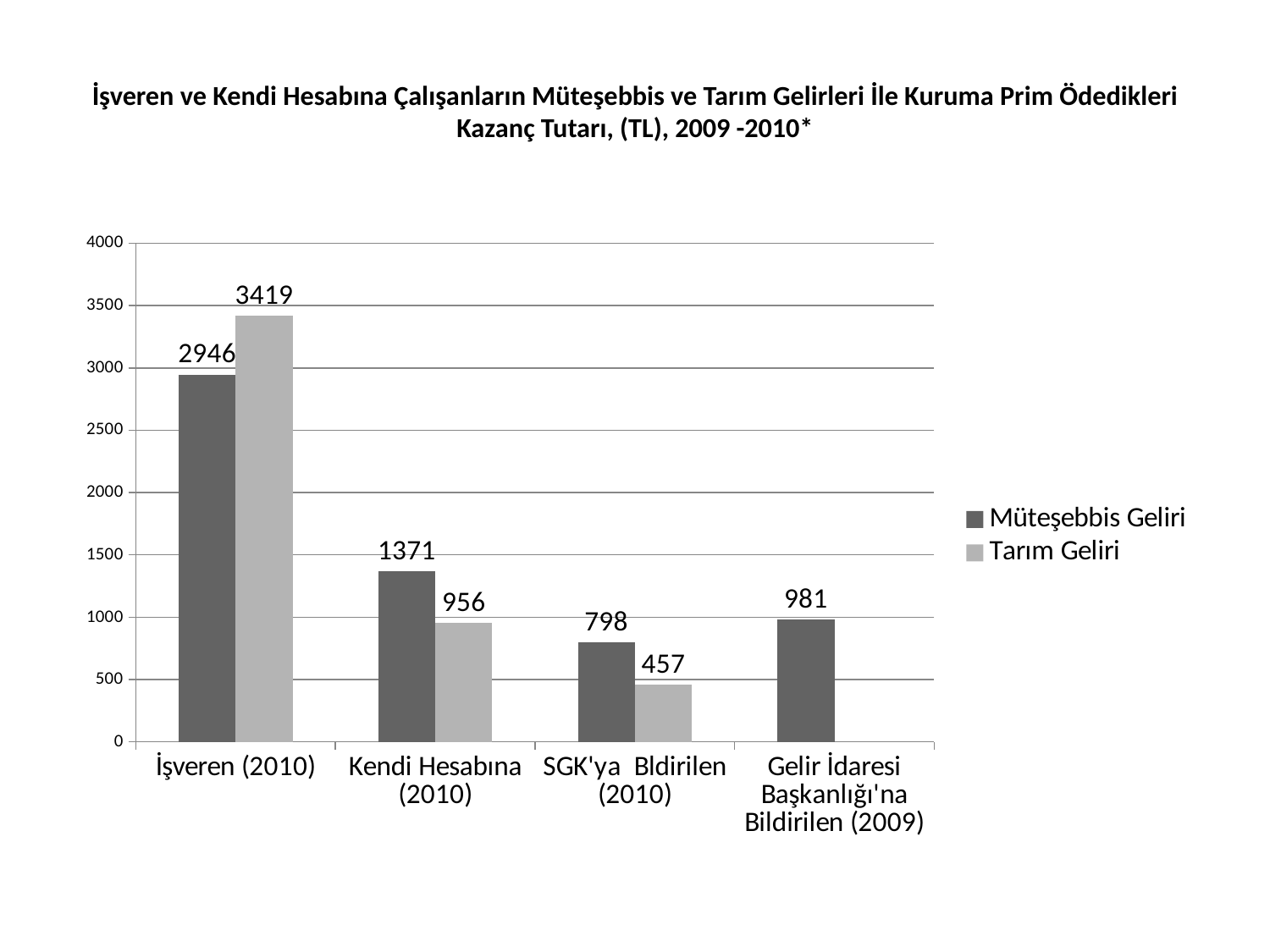
Which category has the highest Tarım Geliri value? İşveren (2010) What is the Müteşebbis Geliri value for İşveren (2010)? 2946 How many categories are shown on the x axis? 4 Which is larger for Kendi Hesabına (2010): Müteşebbis Geliri or Tarım Geliri? Müteşebbis Geliri What is the difference between the Müteşebbis Geliri values for Kendi Hesabına (2010) and SGK'ya Bldirilen (2010)? 573 What is the Tarım Geliri value for SGK'ya Bldirilen (2010)? 457 Which category has the lowest Müteşebbis Geliri value? SGK'ya Bldirilen (2010) What is the difference between the Tarım Geliri and Müteşebbis Geliri values for İşveren (2010)? 473 How many series does the legend list? 2 What is the Tarım Geliri value for Kendi Hesabına (2010)? 956 What is the Müteşebbis Geliri value for Gelir İdaresi Başkanlığı'na Bildirilen (2009)? 981 What kind of chart is shown on the slide? Bar chart